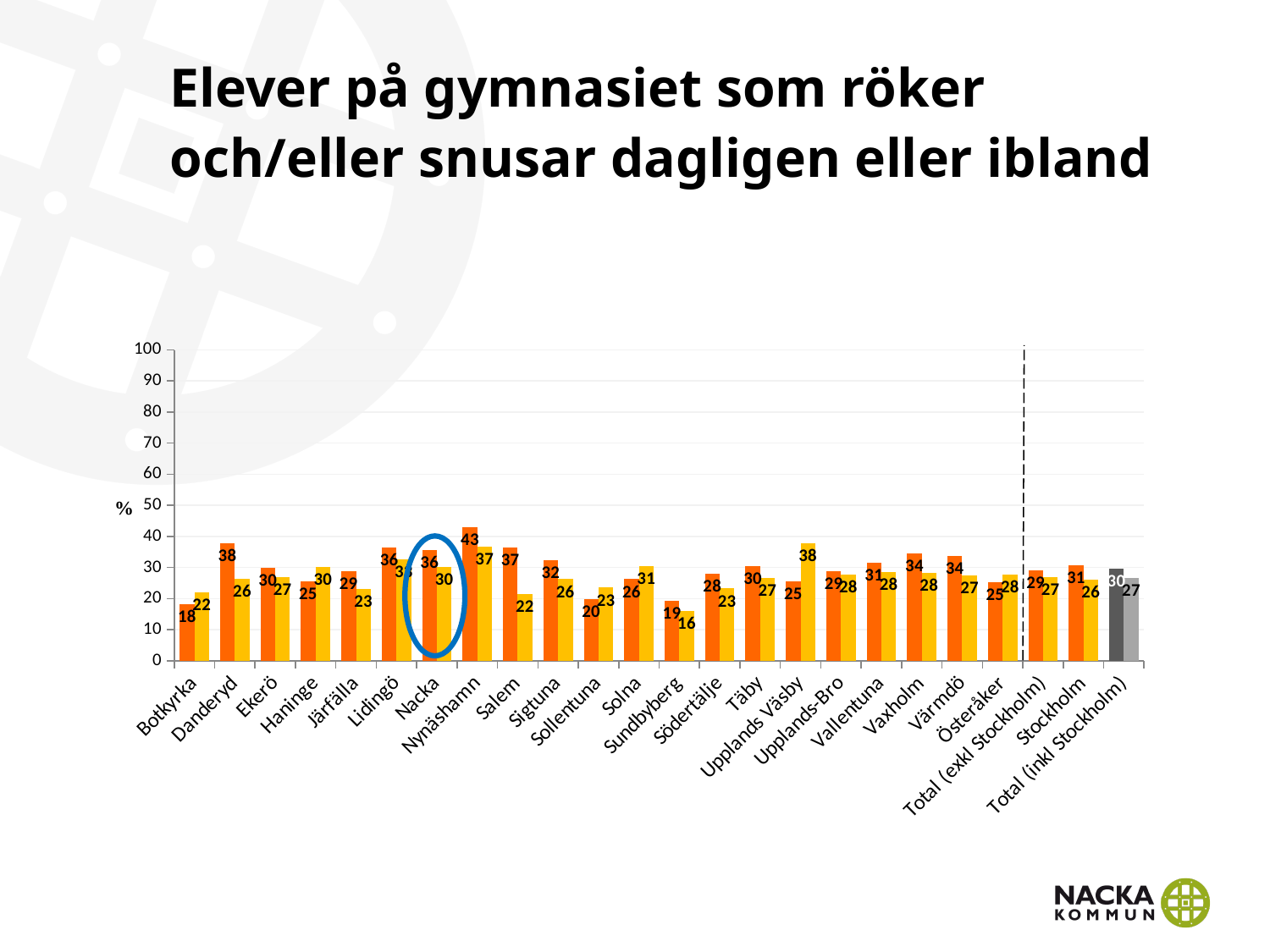
Which municipality has the highest orange (first) bar? Nynäshamn Which municipality has the lowest yellow (second) bar? Sundbyberg What is the value of the dark grey bar for Total (inkl Stockholm)? 30 What is the value of the orange (first) bar for Nacka? 36 How many categories are shown on the x axis? 24 What is the value of the yellow (second) bar for Upplands Väsby? 38 What is the value of the yellow (second) bar for Nynäshamn? 37 What kind of chart is shown on the slide? bar chart Which is larger for Danderyd, the orange (first) bar or the yellow (second) bar? the orange (first) bar What is the difference between the orange bar and the yellow bar for Salem? 15 Which municipality is circled in blue on the chart? Nacka Is the value of the orange bar for Nynäshamn greater or less than 40? greater